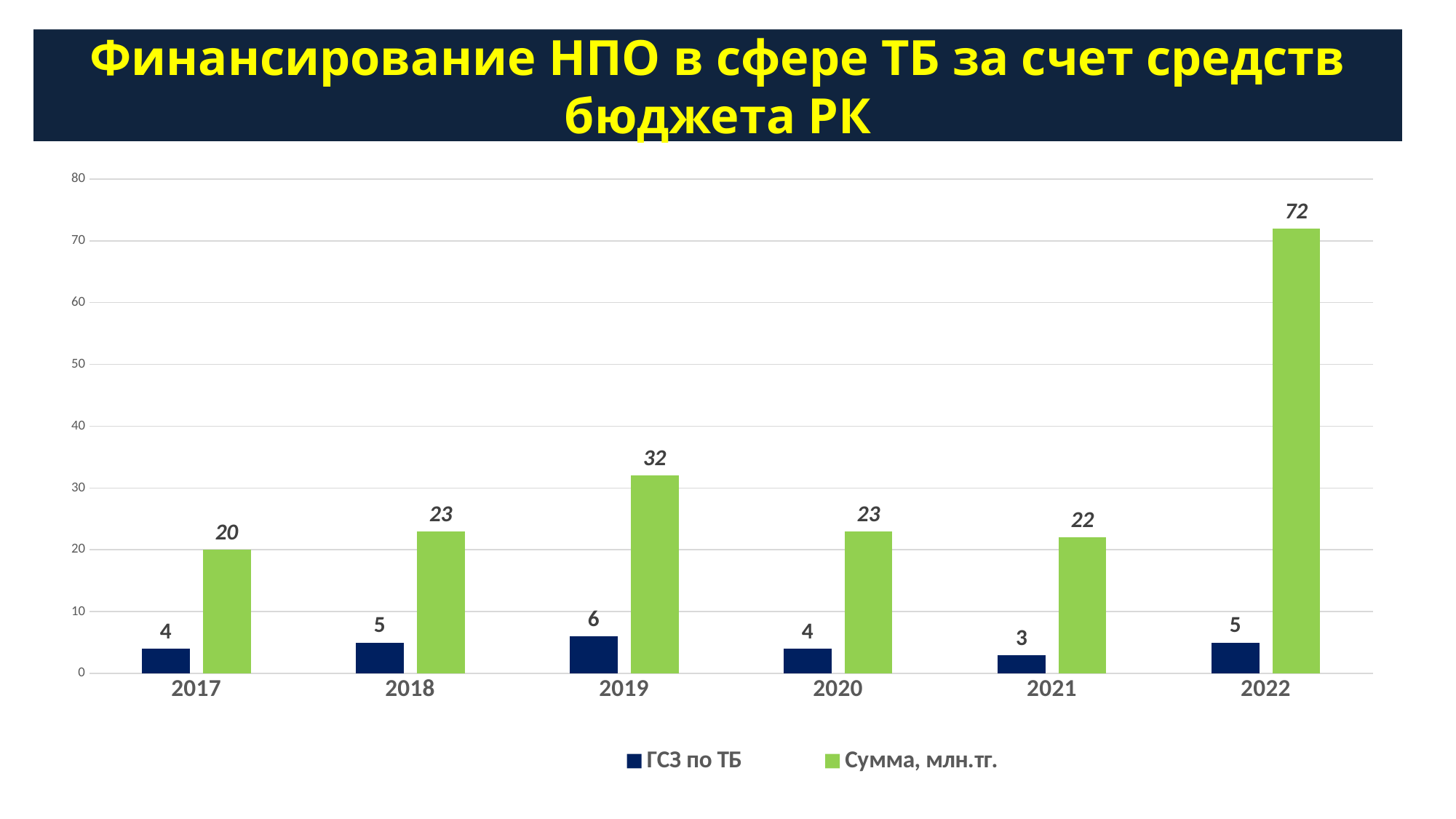
Which year has the highest value for Сумма, млн.тг.? 2022 Which year has the lowest value for ГСЗ по ТБ? 2021 What is the value of ГСЗ по ТБ for 2019? 6 What kind of chart is shown on the slide? bar chart Did the value of Сумма, млн.тг. rise or fall from 2021 to 2022? rise What is the value of Сумма, млн.тг. for 2017? 20 Which is larger: the Сумма, млн.тг. value for 2018 or for 2021? 2018 How many series does the legend list? 2 How many years are shown on the x axis? 6 What colour are the bars for the series Сумма, млн.тг.? green What is the difference between the Сумма, млн.тг. values for 2022 and 2019? 40 What is the value of Сумма, млн.тг. for 2022? 72